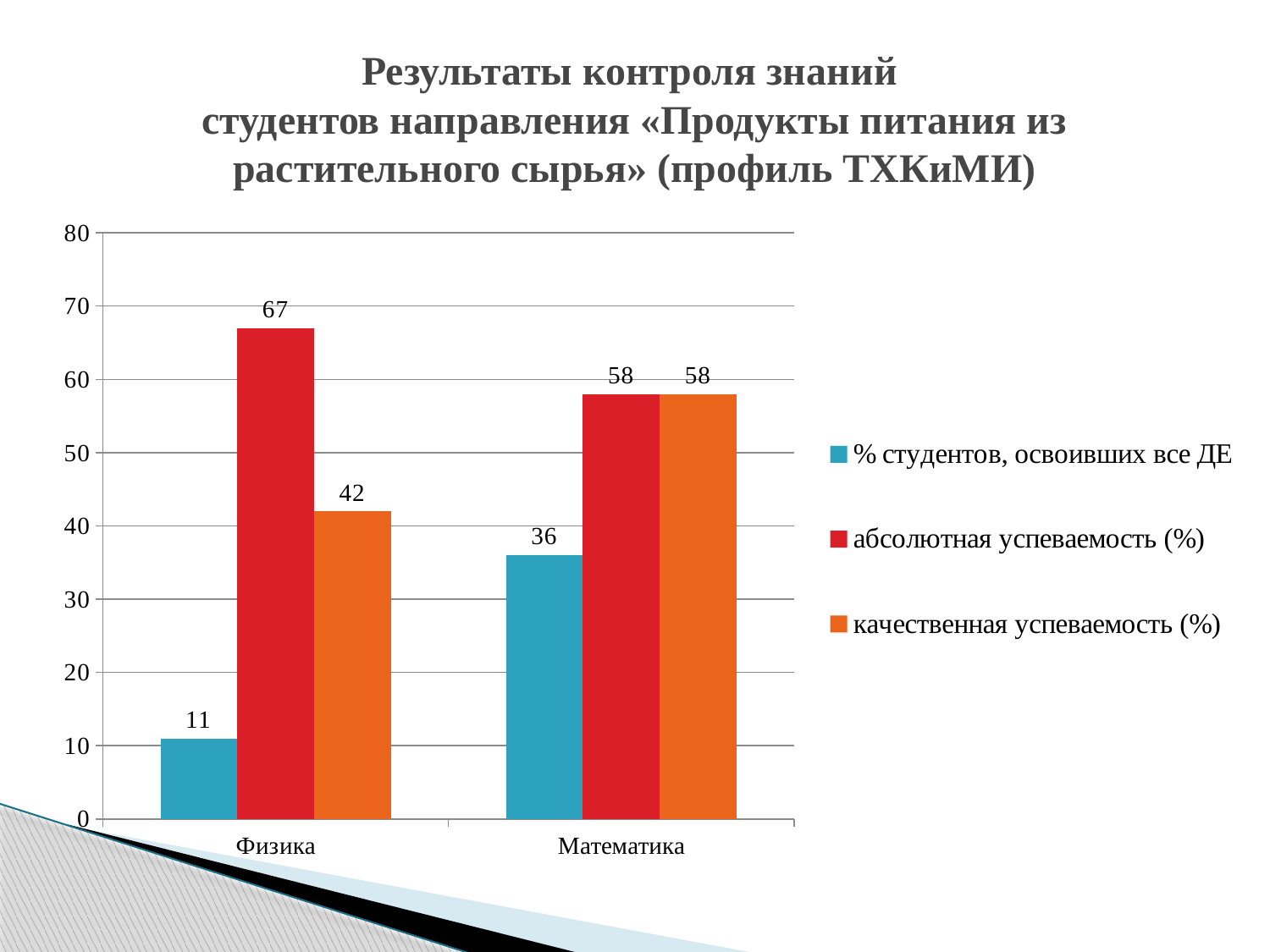
How many series does the legend list? 3 What is the value of «абсолютная успеваемость (%)» for Физика? 67 What kind of chart is shown on the slide? Bar chart What is the value of «% студентов, освоивших все ДЕ» for Физика? 11 What is the value of «качественная успеваемость (%)» for Физика? 42 How many categories are shown on the x axis? 2 Which is larger: «качественная успеваемость (%)» for Физика or for Математика? Математика What is the value of «% студентов, освоивших все ДЕ» for Математика? 36 Which category has the lowest value for «% студентов, освоивших все ДЕ»? Физика What is the difference between «абсолютная успеваемость (%)» and «качественная успеваемость (%)» for Физика? 25 Which category has the highest value for «абсолютная успеваемость (%)»? Физика What is the difference in «% студентов, освоивших все ДЕ» between Математика and Физика? 25